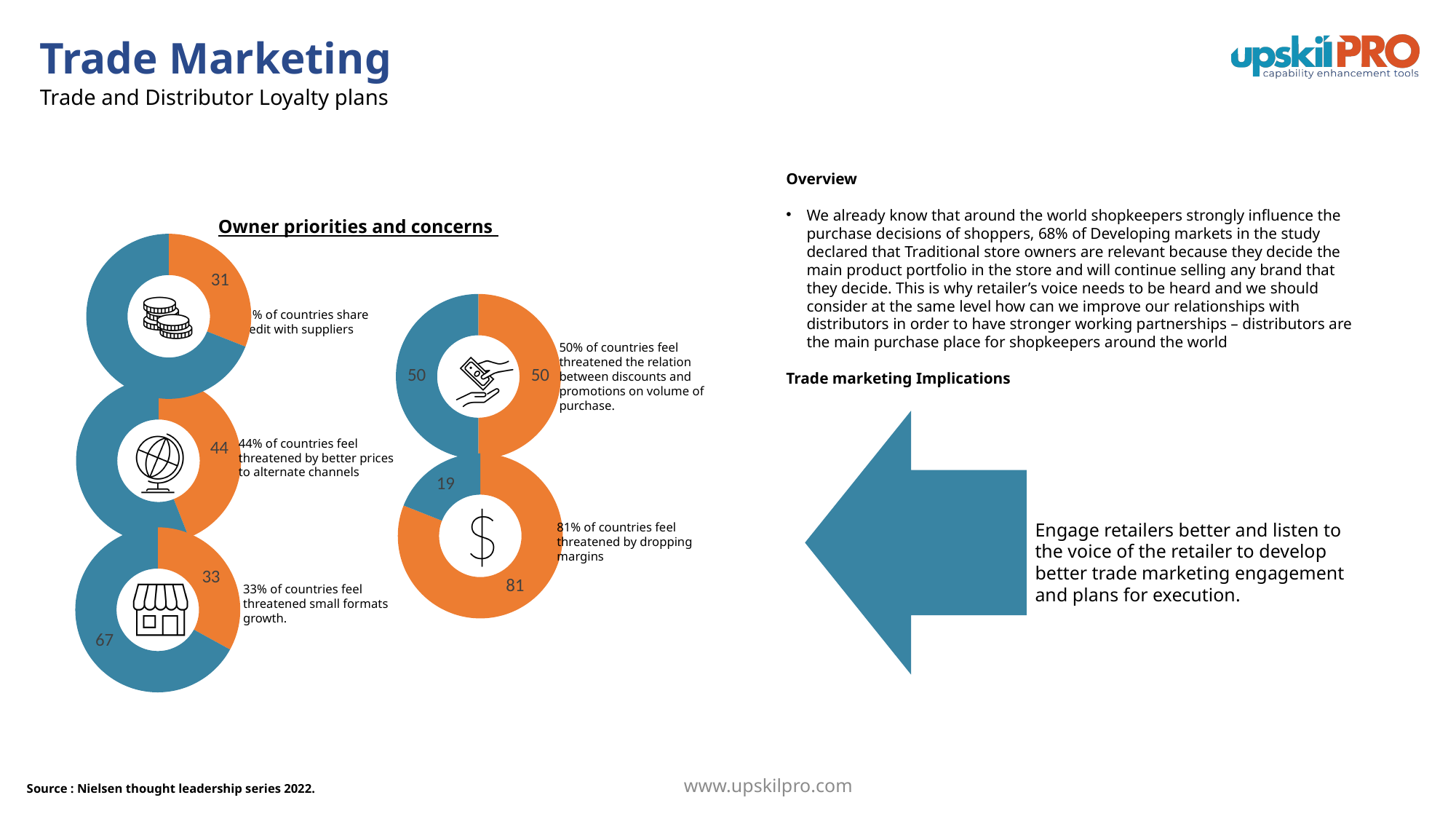
In the donut chart with the dollar-sign icon (bottom right), what value is shown for the orange slice? 81 What kind of charts are shown under the heading 'Owner priorities and concerns'? Donut (pie) charts How many donut charts are shown under 'Owner priorities and concerns'? 5 In the donut chart with the store icon (bottom left), what value is shown for the orange slice? 33 In the donut chart with the dollar-sign icon (bottom right), what is the difference between the orange slice (81) and the blue slice (19)? 62 In the donut chart with the dollar-sign icon (bottom right), what value is shown for the blue slice? 19 In the donut chart with the store icon (bottom left), which slice is larger, the orange or the blue? Blue In the donut chart with the coins icon (top left), what value is shown for the orange slice? 31 In the donut chart with the hand-and-money icon (top right), what value is shown for each of the two slices? 50 and 50 In the donut chart with the globe icon (middle left), what value is shown for the orange slice? 44 In the donut chart with the store icon (bottom left), what value is shown for the blue slice? 67 What is the title above the group of donut charts? Owner priorities and concerns